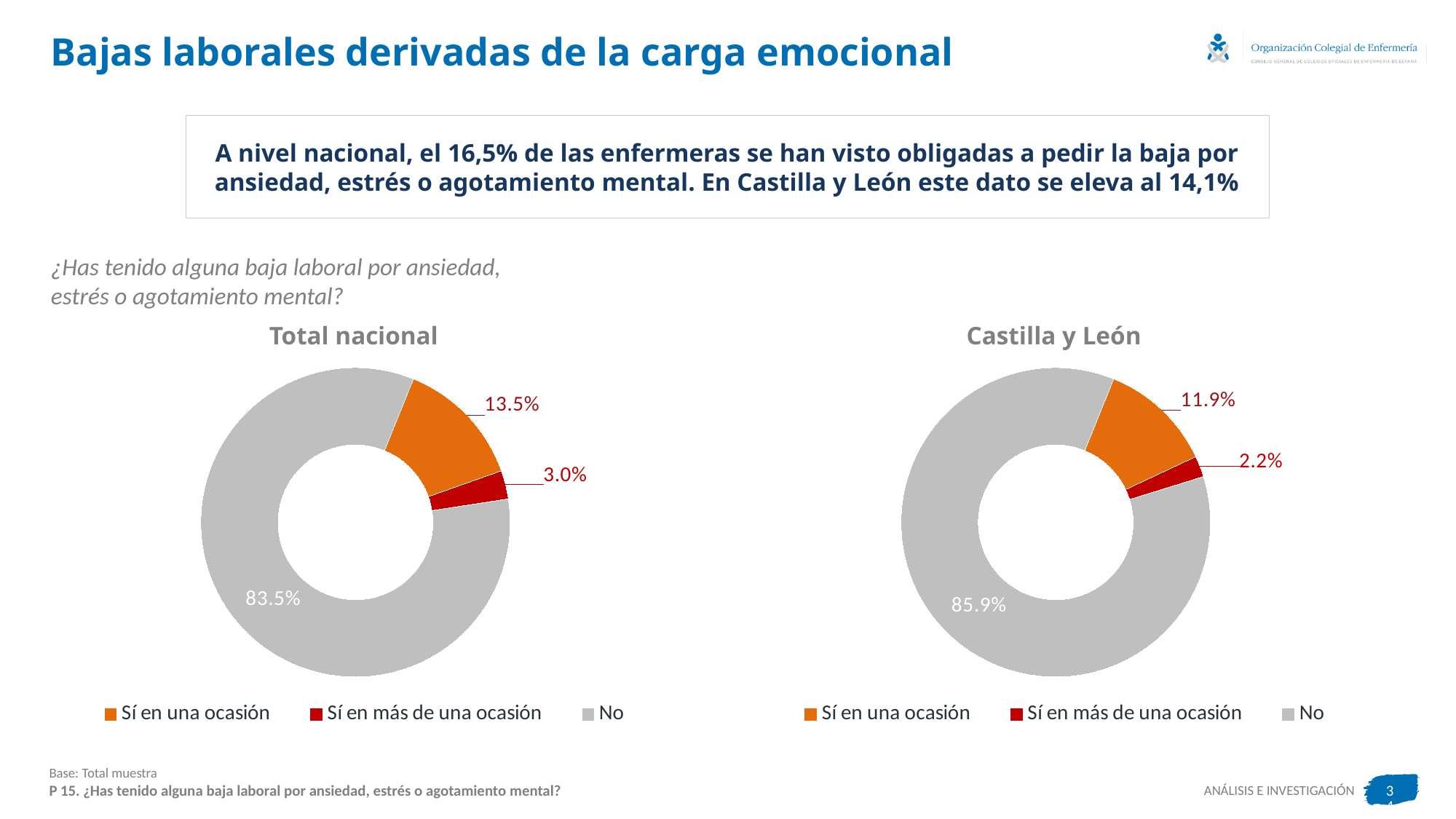
In the 'Total nacional' chart, which category has the smallest share? Sí en más de una ocasión Which is larger: 'Sí en una ocasión' in the 'Total nacional' chart or 'Sí en una ocasión' in the 'Castilla y León' chart? Total nacional In the 'Total nacional' chart, what is the value for 'No'? 83.5% In the 'Castilla y León' chart, which category has the largest share? No In the 'Castilla y León' chart, what is the value for 'No'? 85.9% In the 'Castilla y León' chart, what is the value for 'Sí en más de una ocasión'? 2.2% In the 'Total nacional' chart, what colour is the 'No' slice? Grey In the 'Total nacional' chart, what is the difference between 'Sí en una ocasión' and 'Sí en más de una ocasión'? 10.5% What is the title of the chart on the right side of the slide? Castilla y León What kind of chart is the 'Total nacional' chart? Doughnut chart How many categories does the 'Castilla y León' chart show? 3 In the 'Total nacional' chart, what is the value for 'Sí en una ocasión'? 13.5%